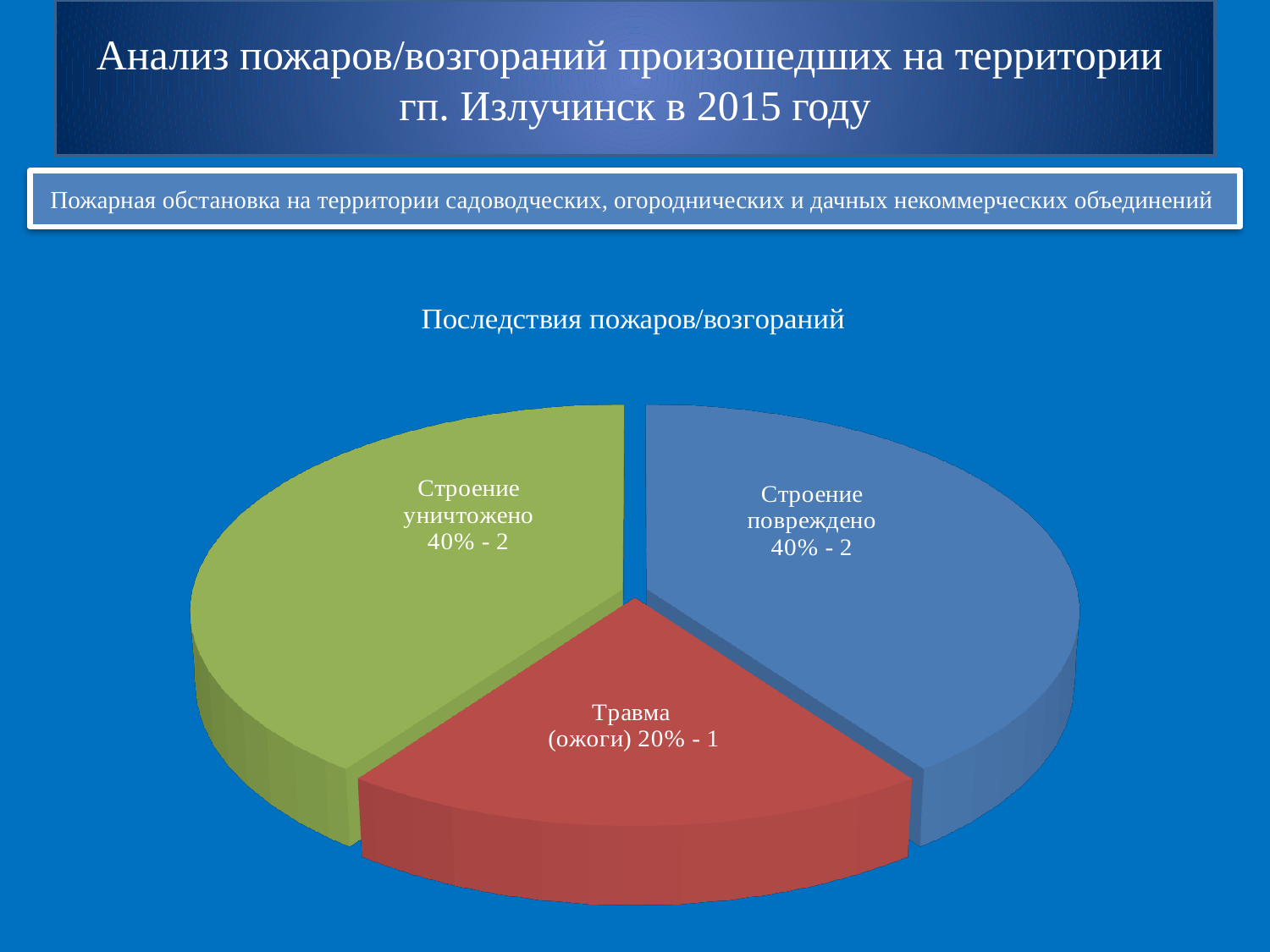
What share of the pie does "Травма (ожоги)" represent? 20% What is the difference in percentage points between "Строение повреждено" and "Травма (ожоги)"? 20% What count is shown for "Строение повреждено"? 2 What is the title of the chart? Последствия пожаров/возгораний How many slices does the pie chart have? 3 What kind of chart is shown on the slide? pie chart Which category has the smallest slice of the pie? Травма (ожоги) What share of the pie does "Строение уничтожено" represent? 40% Which is larger: the slice for "Строение уничтожено" or the slice for "Травма (ожоги)"? Строение уничтожено What colour is the slice for "Травма (ожоги)"? red What count is shown for "Травма (ожоги)"? 1 What share of the pie does "Строение повреждено" represent? 40%